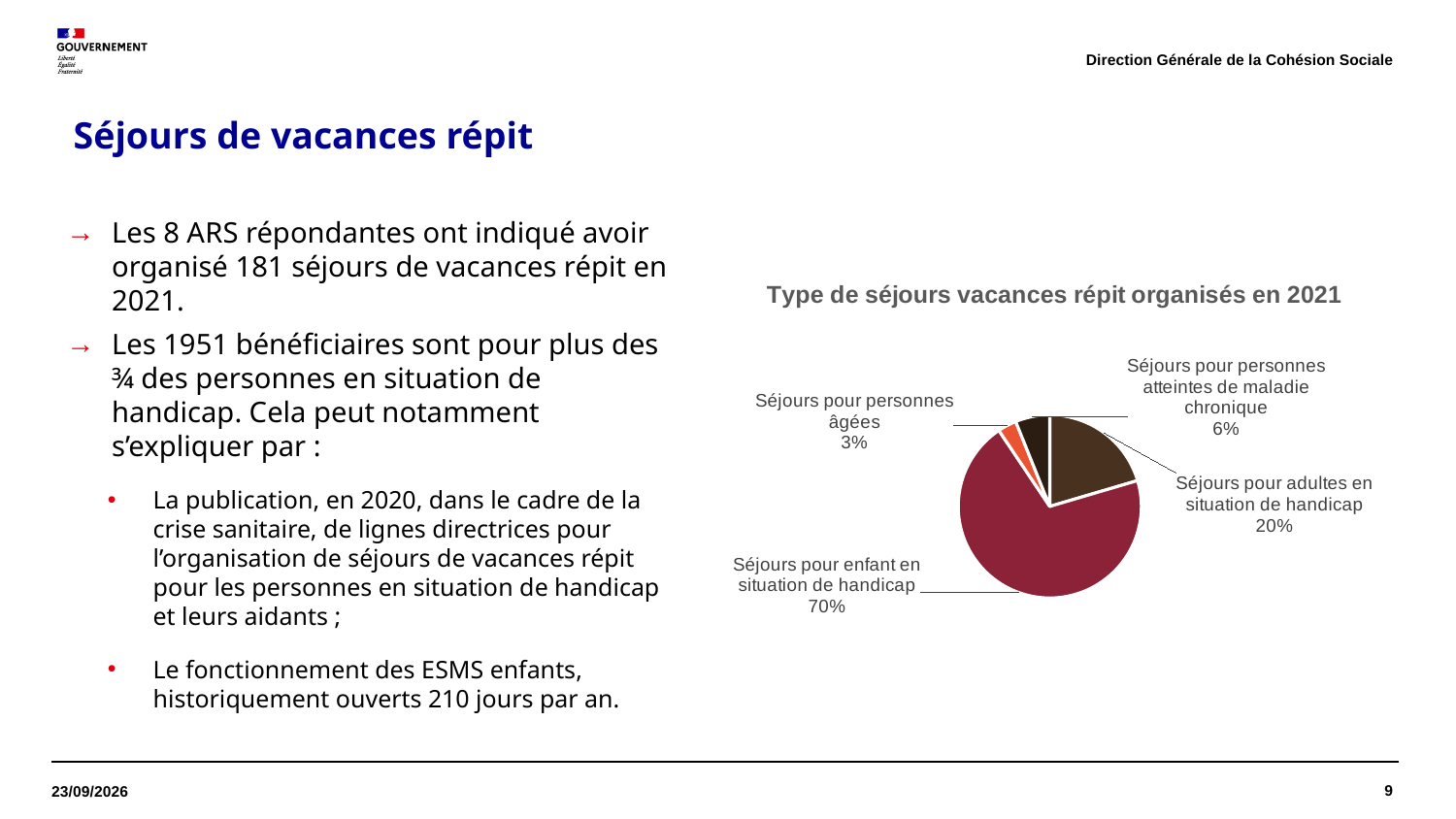
Which category has the largest slice of the pie? Séjours pour enfant en situation de handicap What share of the pie is 'Séjours pour enfant en situation de handicap'? 70% What type of chart is shown on the slide? pie chart Which is larger: the share for 'Séjours pour personnes atteintes de maladie chronique' or for 'Séjours pour personnes âgées'? Séjours pour personnes atteintes de maladie chronique Which category has the smallest slice of the pie? Séjours pour personnes âgées What share of the pie is 'Séjours pour personnes atteintes de maladie chronique'? 6% What share of the pie is 'Séjours pour personnes âgées'? 3% What is the difference in percentage points between 'Séjours pour enfant en situation de handicap' and 'Séjours pour adultes en situation de handicap'? 50 How many categories are shown in the pie chart? 4 What is the difference in percentage points between 'Séjours pour adultes en situation de handicap' and 'Séjours pour personnes atteintes de maladie chronique'? 14 What is the title of the chart? Type de séjours vacances répit organisés en 2021